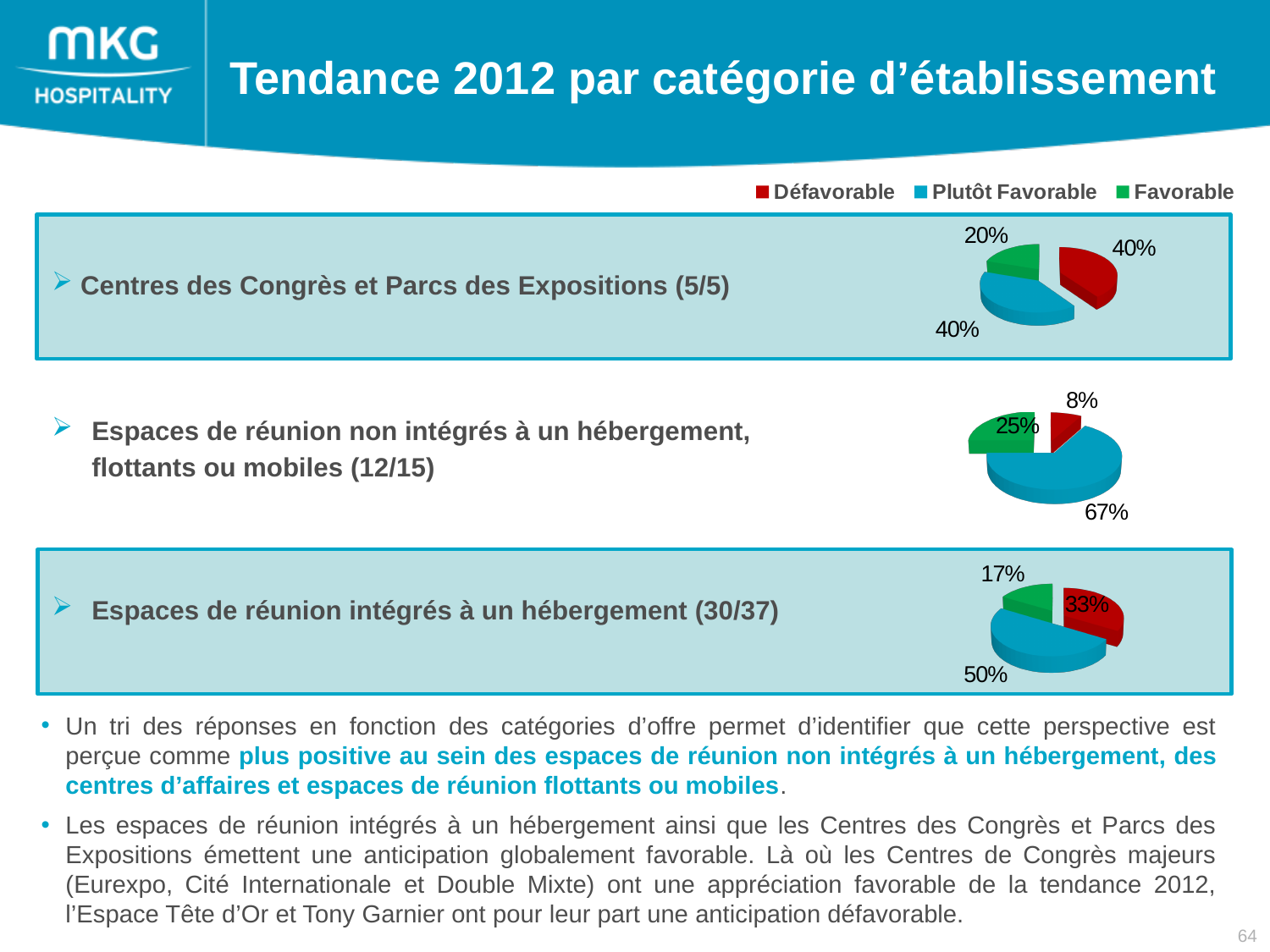
In the pie chart for Espaces de réunion intégrés à un hébergement, what share is Plutôt Favorable? 50% Which colour represents Défavorable in the legend? Red In the pie chart for Espaces de réunion non intégrés à un hébergement, flottants ou mobiles, what share is Défavorable? 8% In the pie chart for Espaces de réunion non intégrés à un hébergement, flottants ou mobiles, what share is Plutôt Favorable? 67% In the pie chart for Centres des Congrès et Parcs des Expositions, what share is Défavorable? 40% In the pie chart for Espaces de réunion non intégrés à un hébergement, flottants ou mobiles, which category has the largest share? Plutôt Favorable Which is larger in the pie chart for Espaces de réunion non intégrés à un hébergement, flottants ou mobiles: Favorable or Défavorable? Favorable In the pie chart for Espaces de réunion intégrés à un hébergement, which category has the smallest share? Favorable What kind of charts are shown on the slide? Pie charts How many series does the legend list? 3 In the pie chart for Centres des Congrès et Parcs des Expositions, what share is Favorable? 20% In the pie chart for Espaces de réunion intégrés à un hébergement, what is the difference between the Défavorable and Favorable shares? 16%